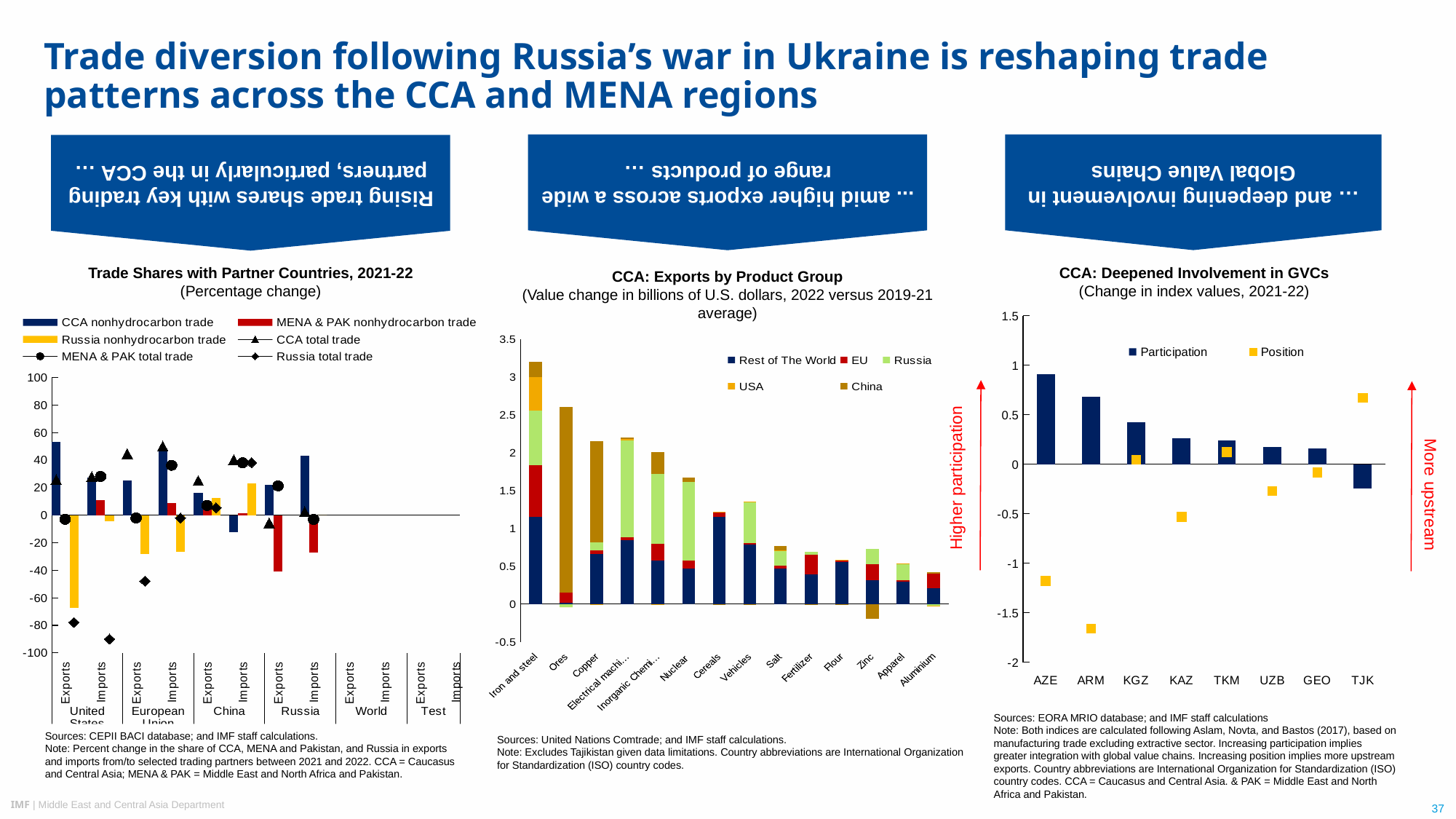
In the 'Trade Shares with Partner Countries, 2021-22' chart, is the Russia nonhydrocarbon trade value for United States Imports greater or less than -60? greater How many product groups are shown on the x axis of the 'CCA: Exports by Product Group' chart? 14 In the 'CCA: Deepened Involvement in GVCs' chart, which country has the lowest Position value? ARM How many series does the legend of the 'CCA: Exports by Product Group' chart list? 5 What kind of chart is the 'CCA: Exports by Product Group' chart? stacked bar chart In the 'CCA: Exports by Product Group' chart, is the total stacked value for Aluminium greater or less than 0.5? less In the 'CCA: Exports by Product Group' chart, is the total stacked value for Iron and steel greater or less than 3? greater In the 'CCA: Deepened Involvement in GVCs' chart, how many countries are shown on the x axis? 8 In the 'CCA: Deepened Involvement in GVCs' chart, which country has the highest Participation value? AZE In the 'CCA: Exports by Product Group' chart, which product group has the tallest stacked bar? Iron and steel How many entries does the legend of the 'Trade Shares with Partner Countries, 2021-22' chart list? 6